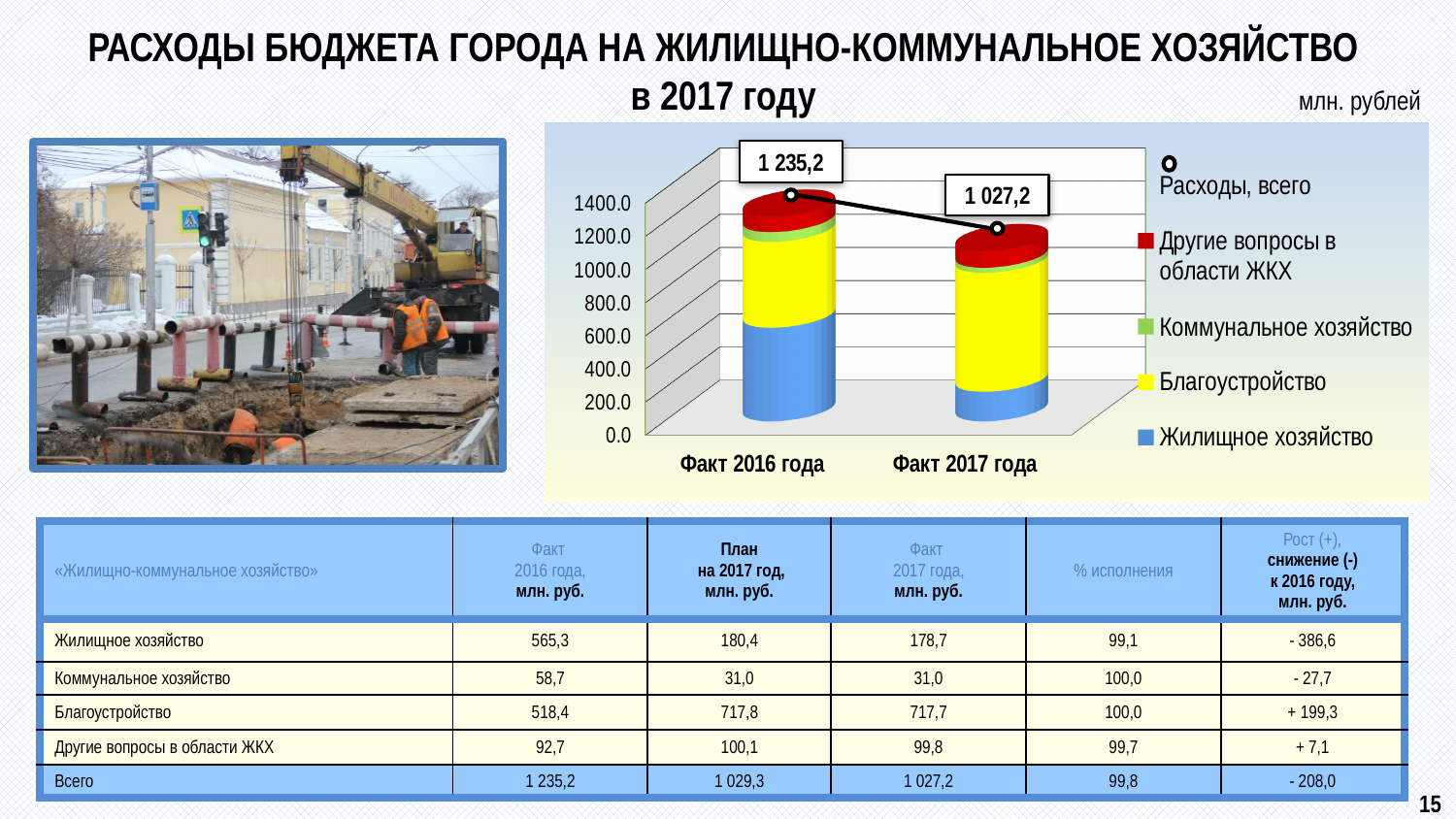
How many categories are shown on the x axis of the chart? 2 Which category has the lower total expenditure? Факт 2017 года What kind of chart is shown on the slide? Stacked bar chart with a line Is the value for Расходы, всего at Факт 2016 года greater or less than 1200.0? greater Which category has the higher total expenditure, Факт 2016 года or Факт 2017 года? Факт 2016 года What is the data label for Расходы, всего at Факт 2017 года? 1 027,2 Does the total expenditure rise or fall from Факт 2016 года to Факт 2017 года? Fall What is the data label for Расходы, всего at Факт 2016 года? 1 235,2 By how much did Расходы, всего decrease from Факт 2016 года to Факт 2017 года? 208,0 Is the Жилищное хозяйство segment for Факт 2017 года greater or less than 400.0? less How many entries does the chart legend list? 5 Is the Жилищное хозяйство segment for Факт 2016 года greater or less than 400.0? greater